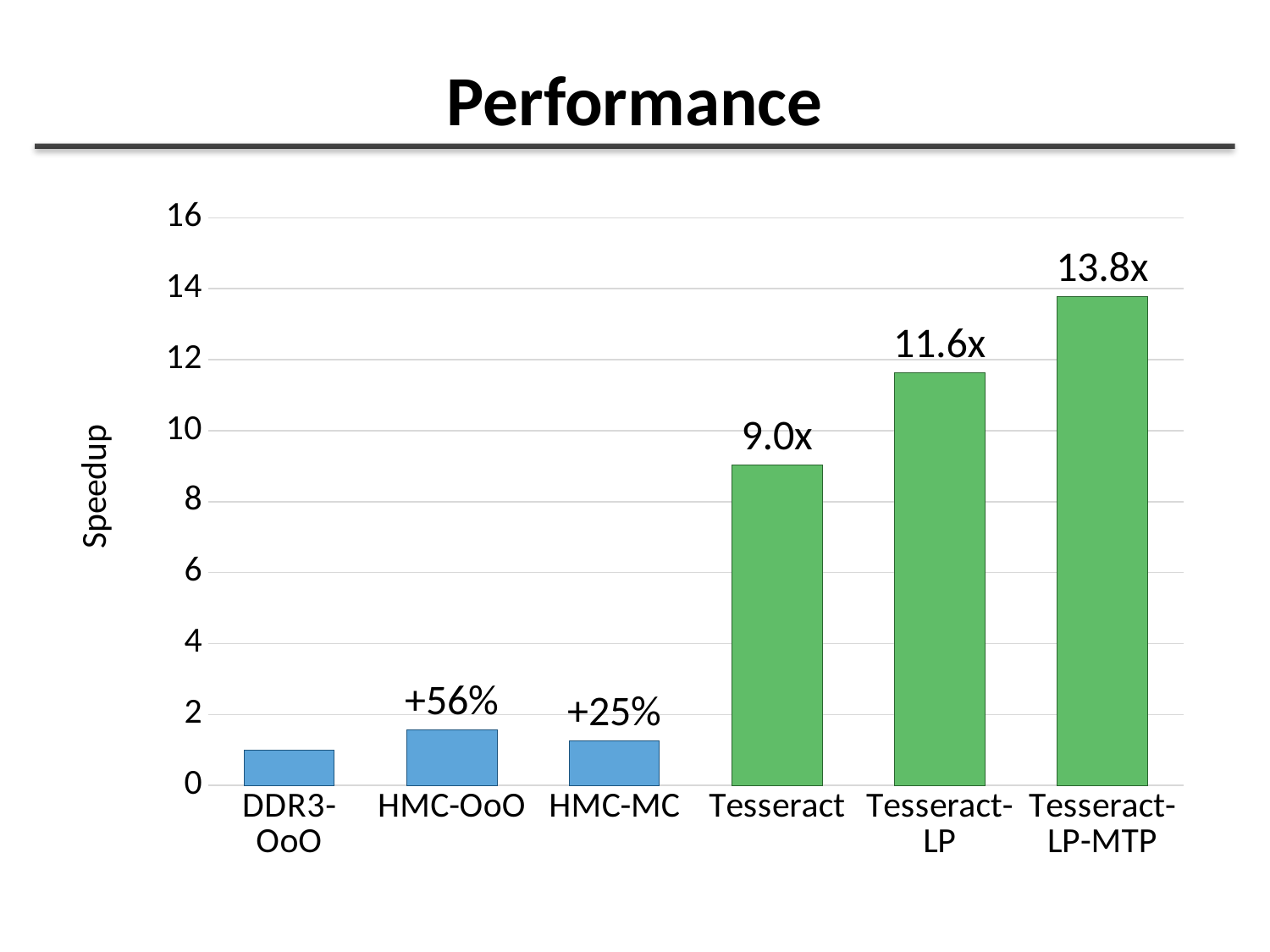
How many categories are shown on the x axis? 6 What is the difference in speedup between Tesseract-LP-MTP and Tesseract? 4.8x What label is printed above the HMC-OoO bar? +56% Which category has the highest speedup? Tesseract-LP-MTP What is the speedup shown for Tesseract? 9.0x What is the difference in speedup between Tesseract-LP and Tesseract? 2.6x Is the speedup for DDR3-OoO greater or less than 2? less What type of chart is shown on the slide? bar chart Which category has the lowest speedup? DDR3-OoO Which has a larger speedup, HMC-OoO or HMC-MC? HMC-OoO What is the speedup shown for Tesseract-LP-MTP? 13.8x What is the speedup shown for Tesseract-LP? 11.6x